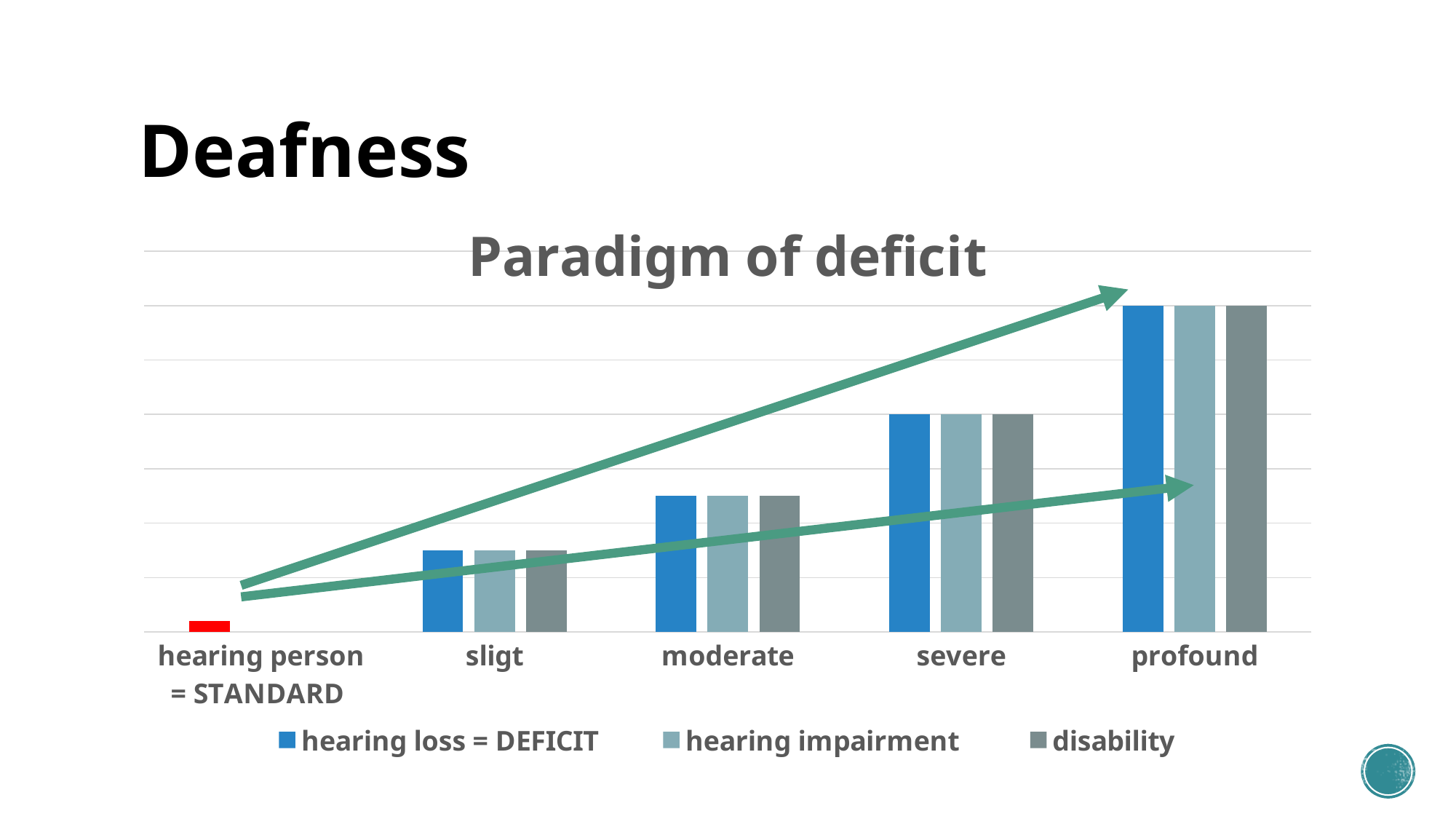
What is the first series listed in the chart's legend? hearing loss = DEFICIT How many categories are shown along the x axis of the chart? 5 Which category is plotted immediately to the right of moderate? severe Which category has taller bars, severe or moderate? severe What is the title of the chart? Paradigm of deficit Do the bar heights rise or fall moving from left to right along the x axis? rise What kind of chart is shown on the slide? bar chart Which category has the shortest bar in the chart? hearing person = STANDARD How many series does the chart's legend list? 3 Which category has the tallest bars in the chart? profound Which category has taller bars, sligt or profound? profound